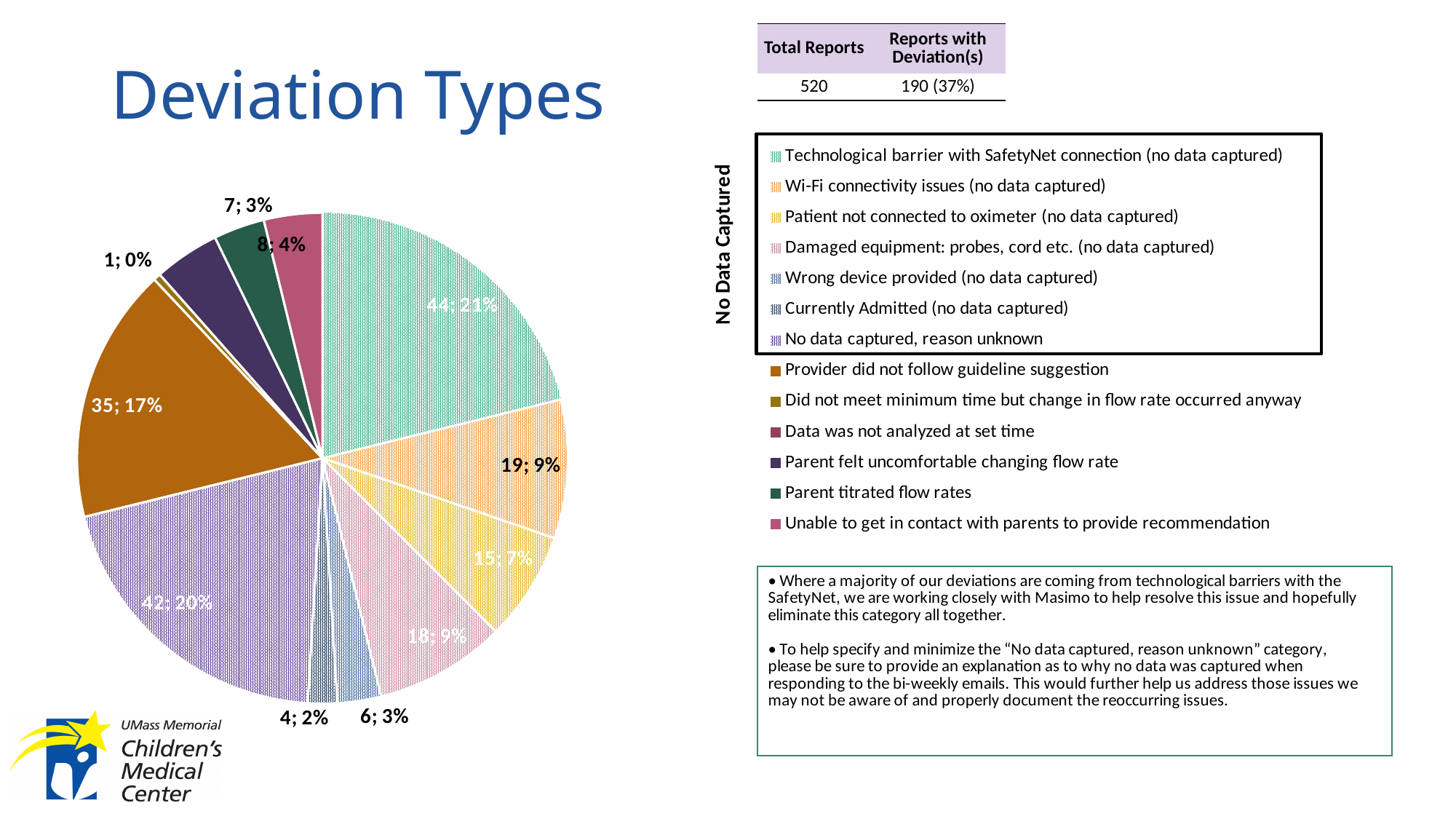
How many legend entries are grouped inside the 'No Data Captured' box? 7 Which category has the largest slice of the pie? Technological barrier with SafetyNet connection (no data captured) What is the data label for the 'No data captured, reason unknown' slice? 42; 20% What share of the pie does 'Provider did not follow guideline suggestion' represent? 17% What is the difference in count between 'Technological barrier with SafetyNet connection' and 'No data captured, reason unknown'? 2 Which has a higher count: 'Wi-Fi connectivity issues (no data captured)' or 'Damaged equipment: probes, cord etc. (no data captured)'? Wi-Fi connectivity issues (no data captured) What is the data label for the 'Wrong device provided (no data captured)' slice? 6; 3% What is the data label for the 'Currently Admitted (no data captured)' slice? 4; 2% How many categories does the legend of the pie chart list? 13 What is the data label for the 'Technological barrier with SafetyNet connection (no data captured)' slice? 44; 21% What kind of chart is shown on the slide? pie chart